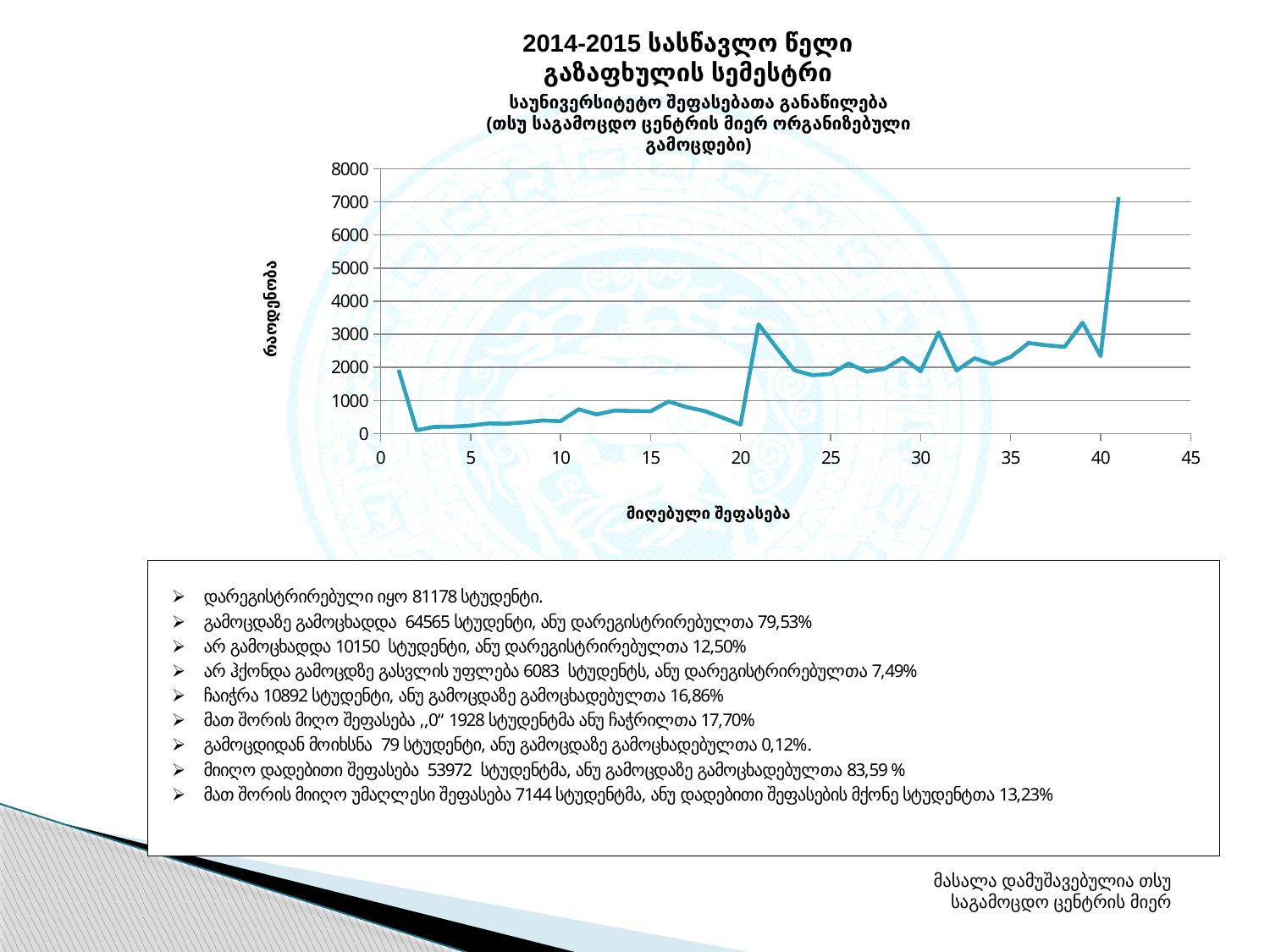
Is the value at x = 31 greater or less than 2000? greater Is the value at x = 10 greater or less than 1000? less Which is larger, the value at x = 16 or the value at x = 2? x = 16 Which is larger, the value at x = 21 or the value at x = 1? x = 21 Is the value at x = 20 greater or less than 1000? less What kind of chart is shown on the slide? line chart What is the title of the x axis of the chart? მიღებული შეფასება Does the line rise or fall between x = 20 and x = 21? rise What is the title of the y axis of the chart? რაოდენობა